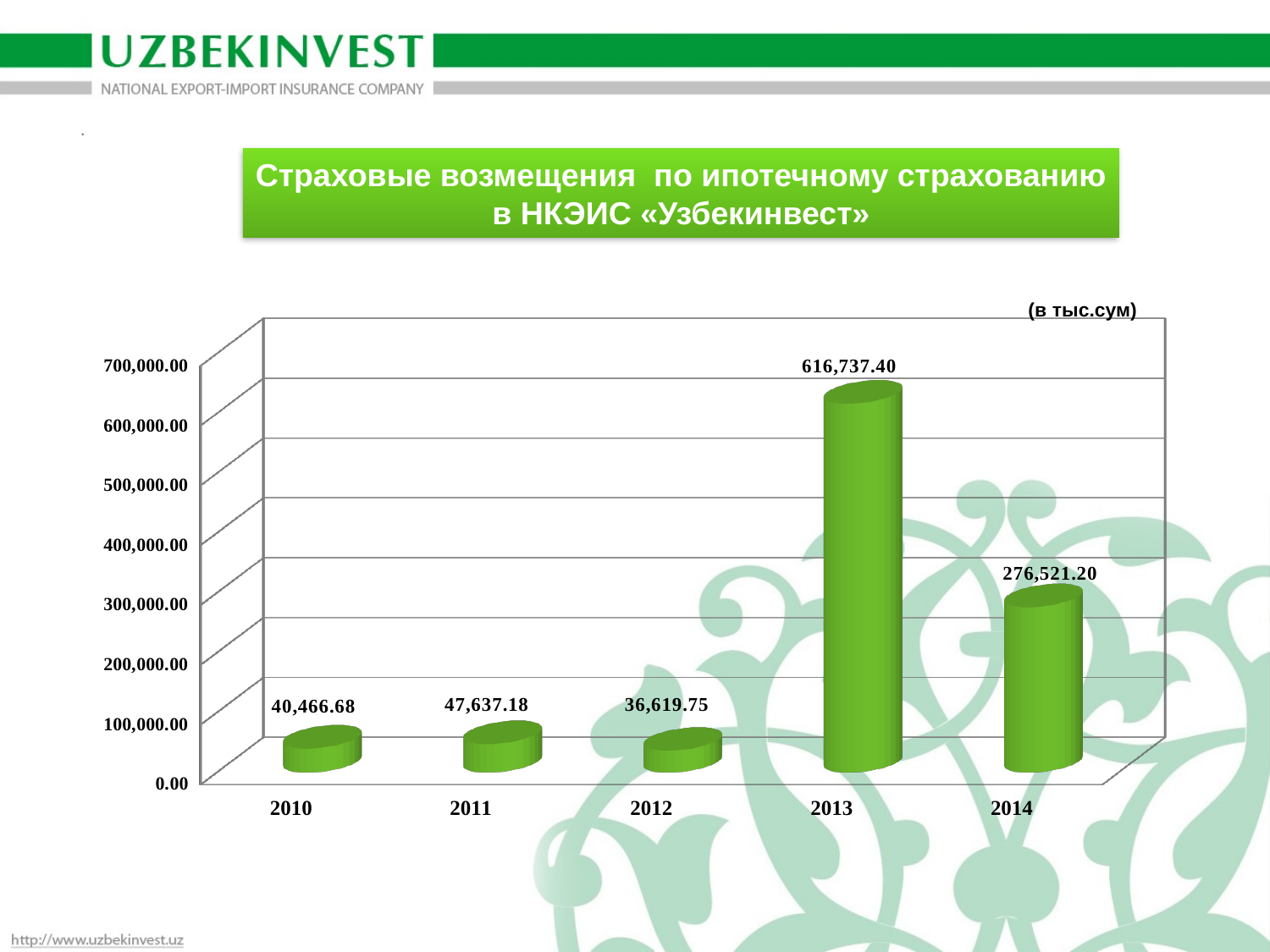
Which year has the highest value? 2013 How many years are shown on the x axis? 5 Which is larger, the value for 2011 or the value for 2012? 2011 Does the value rise or fall from 2013 to 2014? fall What is the value for 2013? 616,737.40 What kind of chart is shown on the slide? bar chart Which year has the lowest value? 2012 What is the value for 2010? 40,466.68 What is the difference between the values for 2011 and 2010? 7,170.50 Is the value for 2014 greater or less than 300,000.00? less What is the value for 2014? 276,521.20 What is the difference between the values for 2013 and 2014? 340,216.20